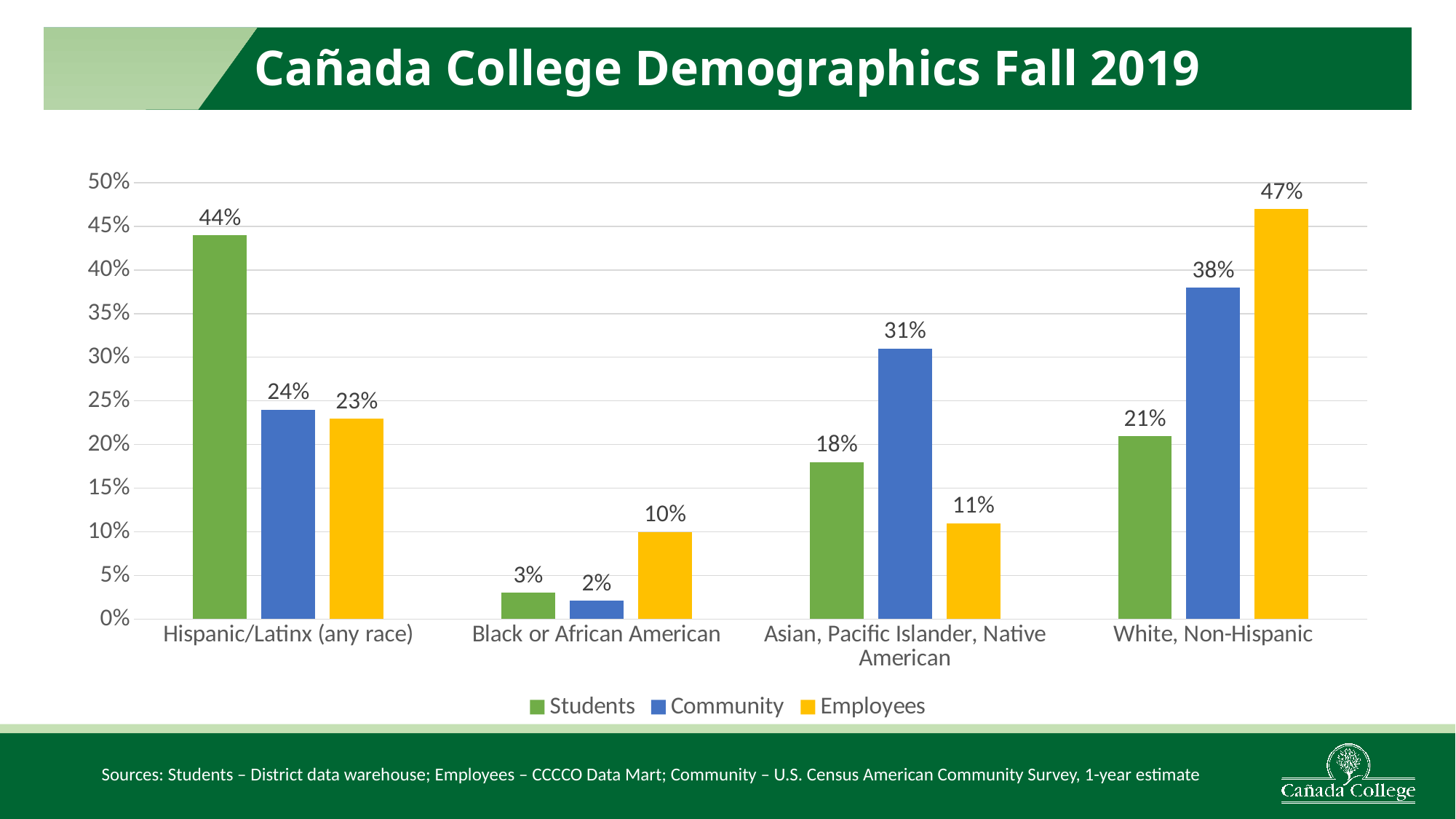
How many series does the legend list? 3 What is the Community value for Black or African American? 2% Which category has the lowest Employees value? Black or African American What kind of chart is shown on the slide? Bar chart What is the difference between the Students and Community values for Hispanic/Latinx (any race)? 20% What is the Community value for Asian, Pacific Islander, Native American? 31% Which is larger for White, Non-Hispanic: the Community value or the Students value? Community What is the Employees value for White, Non-Hispanic? 47% Which series is shown in yellow? Employees Which category has the highest Students value? Hispanic/Latinx (any race) How many categories are shown on the x axis? 4 What percentage of Students are Hispanic/Latinx (any race)? 44%